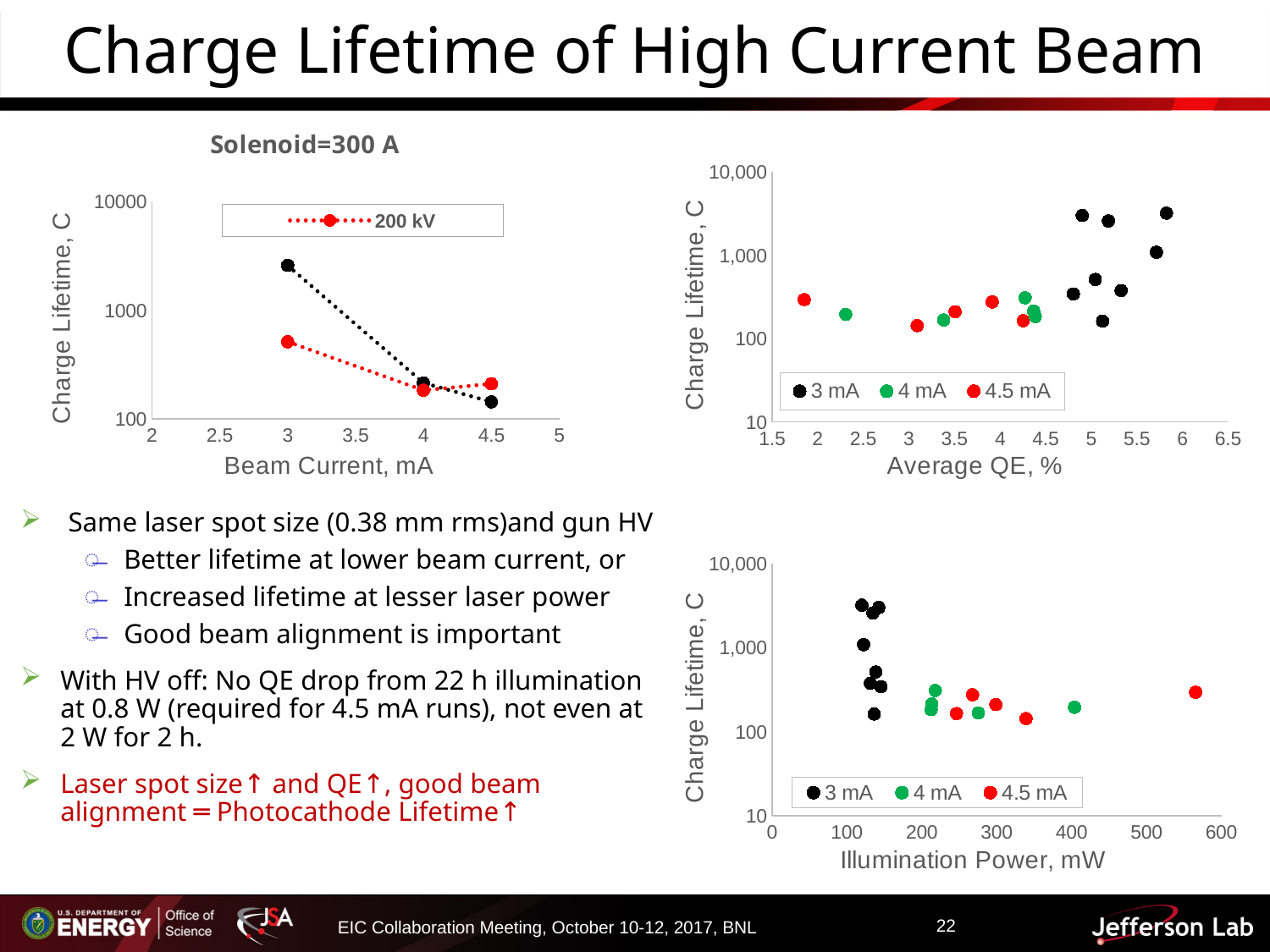
How many series does the legend list in the top-right chart with x-axis 'Average QE, %'? 3 What kind of chart is the top-left chart titled 'Solenoid=300 A'? scatter chart In the top-left chart titled 'Solenoid=300 A', is the red series value at 3 mA greater or less than 1000? less In the top-right chart with x-axis 'Average QE, %', is the 4.5 mA point at the lowest QE (near 2%) greater or less than 100 C? greater In the top-left chart titled 'Solenoid=300 A', what entry does the legend show? 200 kV What is the x-axis label of the bottom-right chart? Illumination Power, mW In the top-left chart titled 'Solenoid=300 A', at a beam current of 3 mA, which series has the larger charge lifetime, the black series or the red series? black series In the top-left chart titled 'Solenoid=300 A', is the black series value at 3 mA greater or less than 1000? greater In the top-right chart with x-axis 'Average QE, %', which series reaches the highest charge lifetime? 3 mA In the top-left chart titled 'Solenoid=300 A', do the black series values rise or fall as beam current increases from 3 mA to 4.5 mA? fall In the bottom-right chart with x-axis 'Illumination Power, mW', which series has the point at the highest illumination power? 4.5 mA How many series does the legend list in the bottom-right chart with x-axis 'Illumination Power, mW'? 3